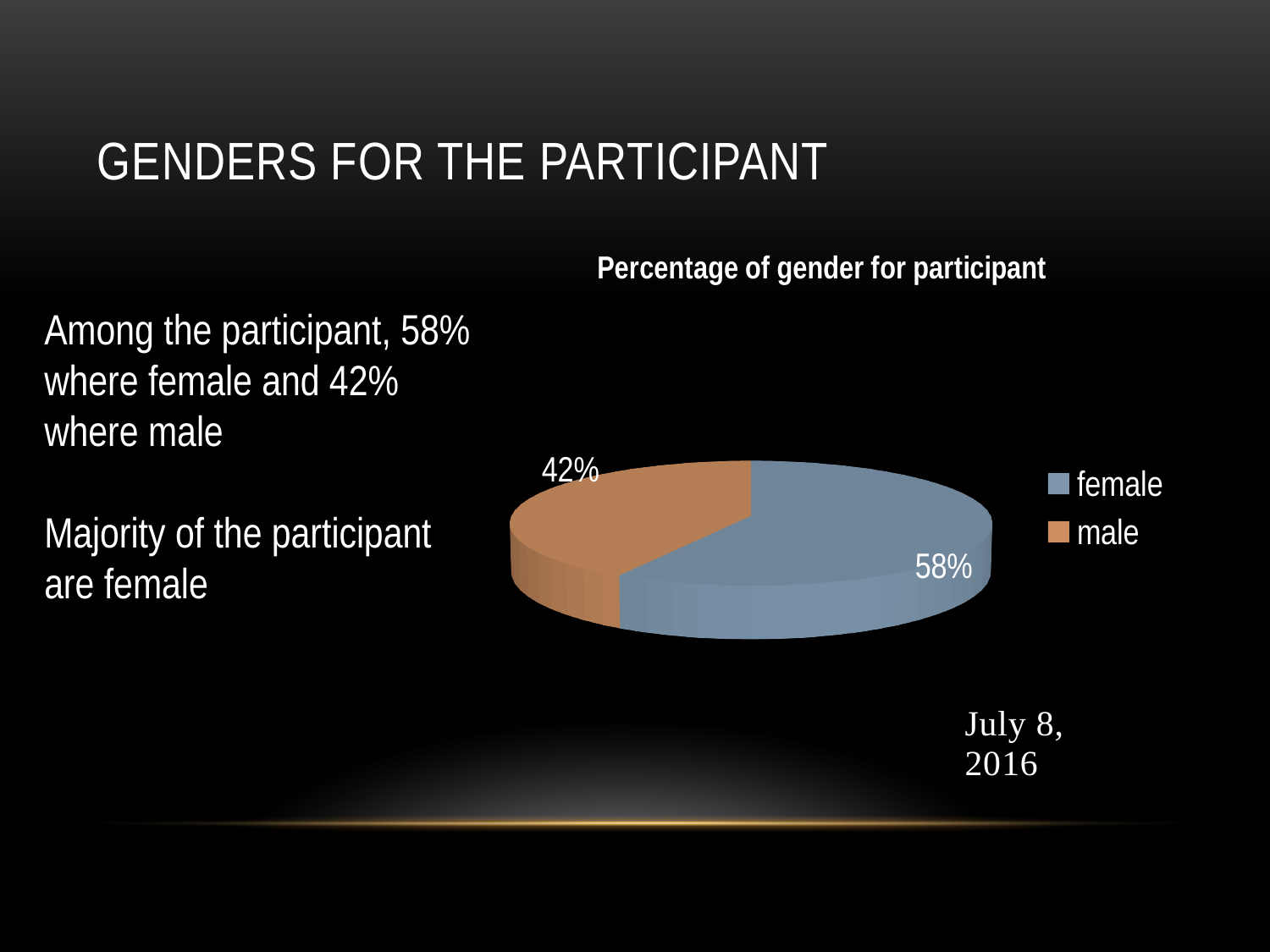
What percentage of the pie chart is female? 58% Which gender has the largest share of the pie chart? female What is the difference in percentage points between the female and male shares? 16 Which gender has the smallest share of the pie chart? male What colour is the male slice in the pie chart? orange What kind of chart is shown on the slide? pie chart Which share is larger, female or male? female What is the title of the chart? Percentage of gender for participant What percentage of the pie chart is male? 42% How many entries does the legend list? 2 How many slices does the pie chart have? 2 What is the total of the two slices in the pie chart? 100%